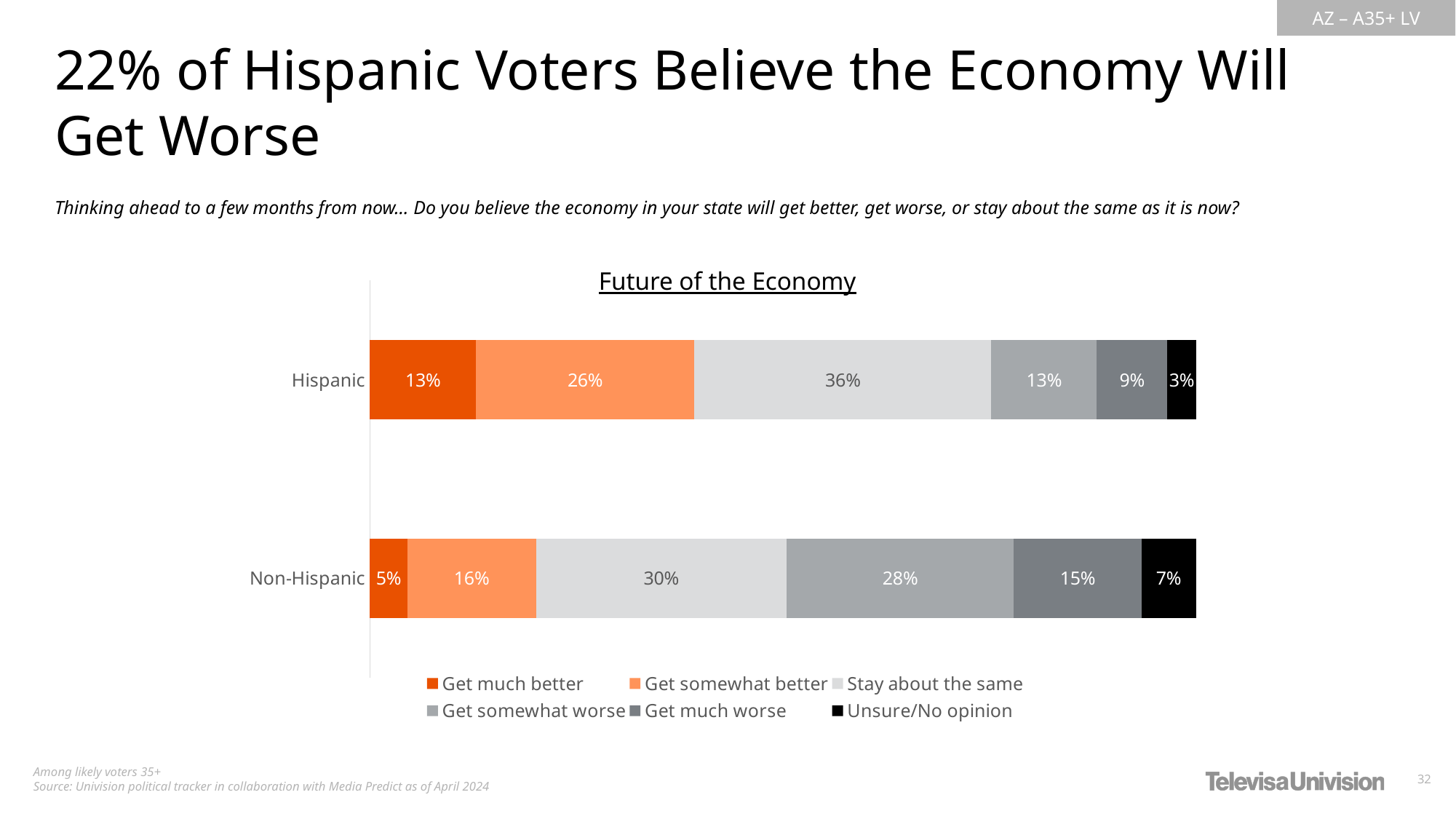
How many groups (bars) are shown in the chart? 2 Which response category has the smallest share among Non-Hispanic voters? Get much better What percentage of Hispanic voters say the economy will stay about the same? 36% Which group has a larger share saying the economy will get much worse, Hispanic or Non-Hispanic? Non-Hispanic What percentage of Hispanic voters say the economy will get much better? 13% What type of chart is shown on the slide? Stacked bar chart What is the difference between the Hispanic and Non-Hispanic shares for 'Get somewhat better'? 10 percentage points Which response category has the largest share among Hispanic voters? Stay about the same What is the title of the chart? Future of the Economy What percentage of Non-Hispanic voters say the economy will get somewhat worse? 28% How many series does the legend list? 6 What percentage of Non-Hispanic voters are unsure or have no opinion? 7%